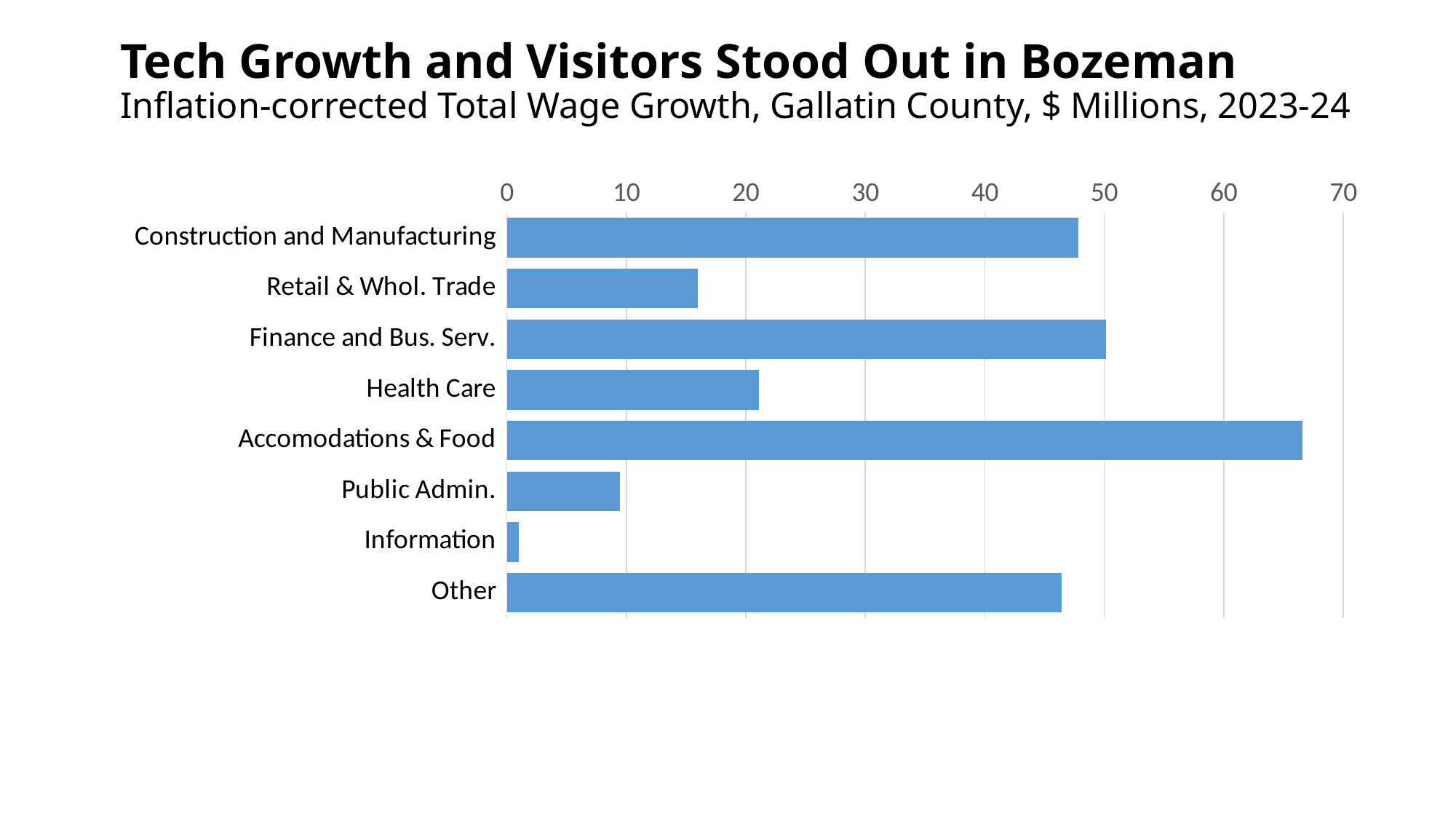
Which category has the lowest inflation-corrected total wage growth? Information What kind of chart is shown on the slide? bar chart Which category has the highest inflation-corrected total wage growth? Accomodations & Food Is the value for Retail & Whol. Trade greater or less than 20? less How many categories are plotted in the chart? 8 What is the title of the slide? Tech Growth and Visitors Stood Out in Bozeman Is the value for Construction and Manufacturing greater or less than 40? greater Is the value for Accomodations & Food greater or less than 60? greater Which is larger, the value for Accomodations & Food or the value for Finance and Bus. Serv.? Accomodations & Food Which is larger, the value for Health Care or the value for Retail & Whol. Trade? Health Care